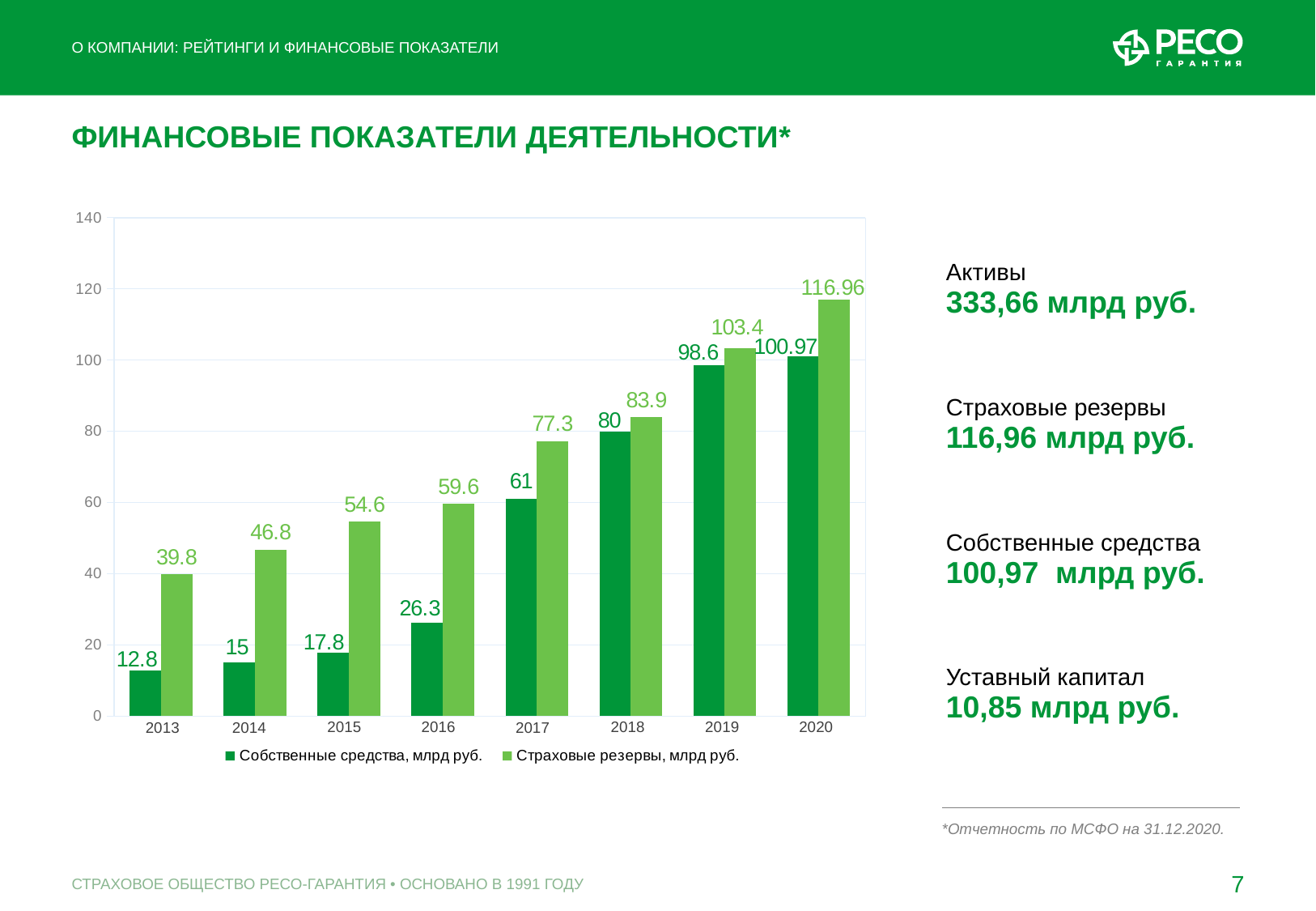
Does Собственные средства, млрд руб. rise or fall from 2013 to 2020? Rise What is the difference between Страховые резервы and Собственные средства in 2018? 3.9 What is the value of Страховые резервы, млрд руб. for 2019? 103.4 What is the value of Собственные средства, млрд руб. for 2016? 26.3 Which is larger in 2017: Собственные средства or Страховые резервы? Страховые резервы What kind of chart is shown on the slide? Bar chart In which year is Страховые резервы, млрд руб. the lowest? 2013 In which year is Собственные средства, млрд руб. the highest? 2020 How many years are shown on the x axis of the chart? 8 Is the value of Страховые резервы, млрд руб. for 2020 greater or less than 100? greater What is the value of Страховые резервы, млрд руб. for 2013? 39.8 How many series does the chart legend list? 2